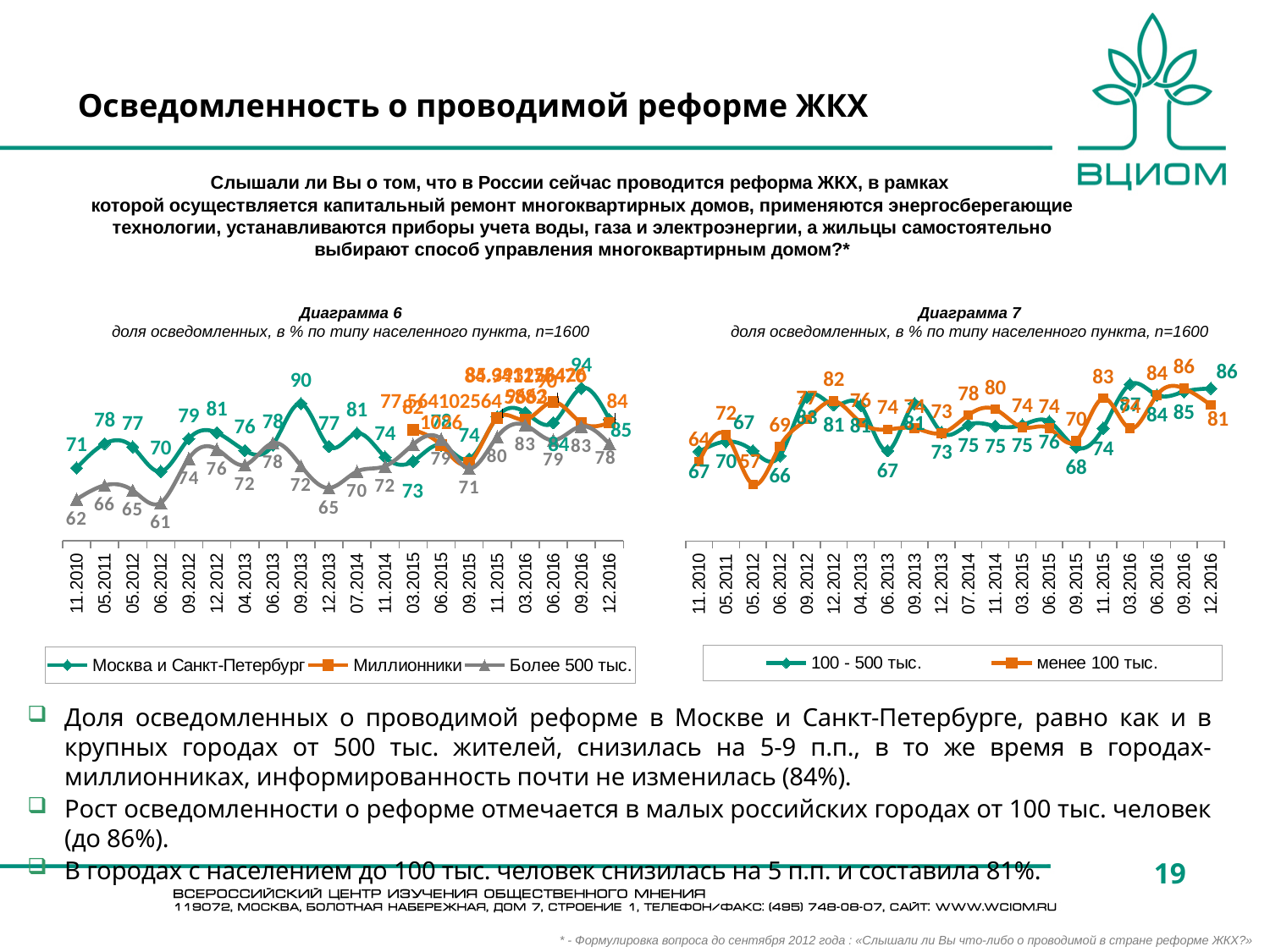
What kind of chart is Диаграмма 6 (the left chart)? Line chart In Диаграмма 6 (the left chart), what is the value for Более 500 тыс. at 11.2010? 62 How many dates are shown on the x axis of Диаграмма 7 (the right chart)? 20 In Диаграмма 6 (the left chart), what is the value for Москва и Санкт-Петербург at 09.2013? 90 In Диаграмма 6 (the left chart), at which date does the Москва и Санкт-Петербург series reach its highest value? 09.2016 In Диаграмма 6 (the left chart), what is the value for Москва и Санкт-Петербург at 11.2010? 71 In Диаграмма 7 (the right chart), at which date does the менее 100 тыс. series reach its lowest value? 05.2012 In Диаграмма 7 (the right chart), what is the value for 100 - 500 тыс. at 12.2016? 86 In Диаграмма 6 (the left chart), at which date does the Более 500 тыс. series reach its lowest value? 06.2012 How many series does the legend of Диаграмма 7 (the right chart) list? 2 How many series does the legend of Диаграмма 6 (the left chart) list? 3 In Диаграмма 6 (the left chart), what is the difference between Москва и Санкт-Петербург and Более 500 тыс. at 11.2010? 9